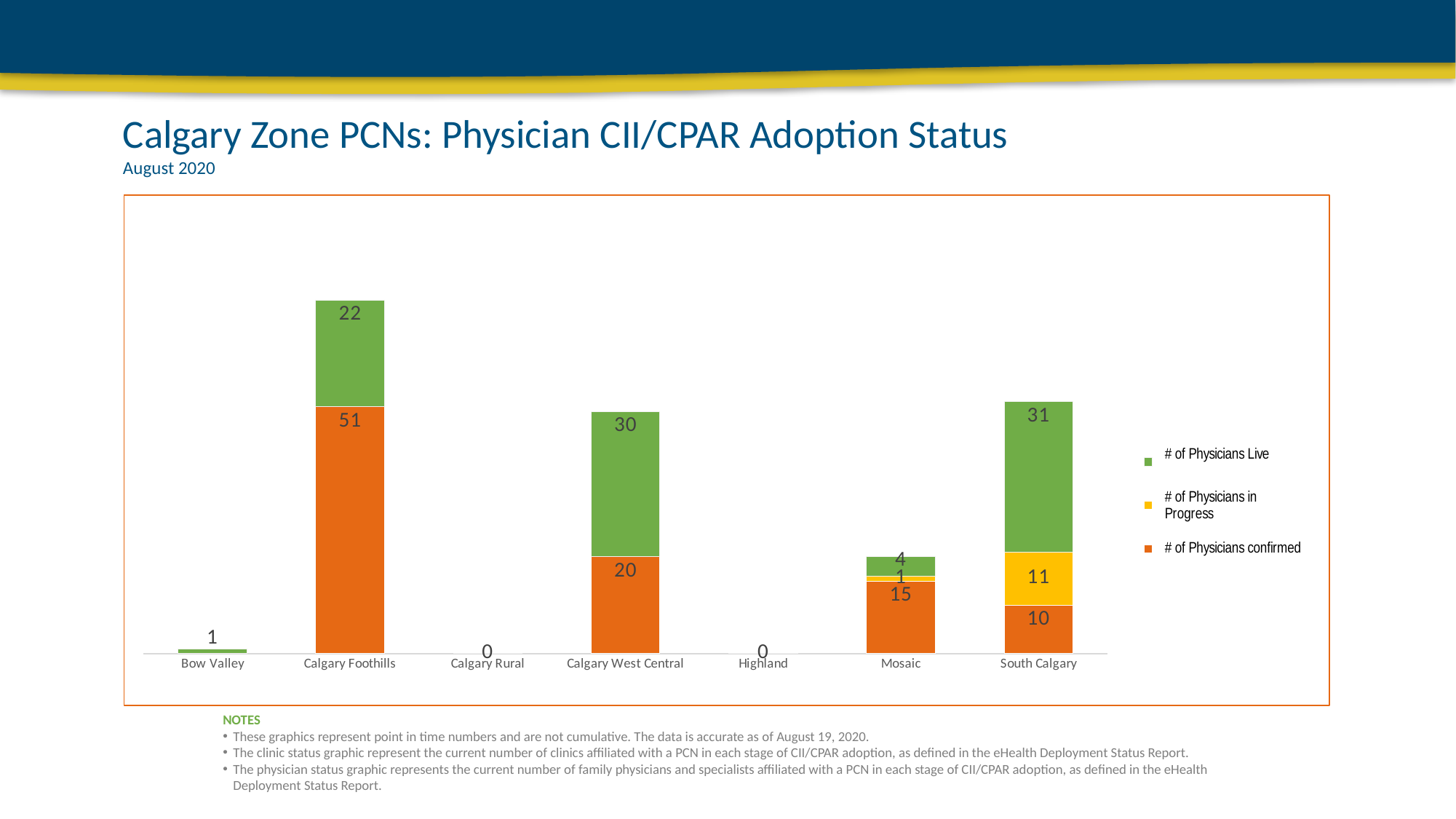
Which PCN has the highest number of physicians live? South Calgary How many PCNs are shown on the x axis? 7 What is the total number of physicians shown for the South Calgary bar? 52 Which is larger: the number of physicians confirmed at Calgary West Central or at South Calgary? Calgary West Central How many physicians are live at Calgary West Central? 30 How many physicians are confirmed at Calgary Foothills? 51 What is the difference between the number of physicians live at South Calgary and at Calgary Foothills? 9 How many series does the legend list? 3 Which PCN has the highest number of physicians confirmed? Calgary Foothills How many physicians are confirmed at Mosaic? 15 What is the total number of physicians shown for the Calgary Foothills bar? 73 How many physicians are in progress at South Calgary? 11